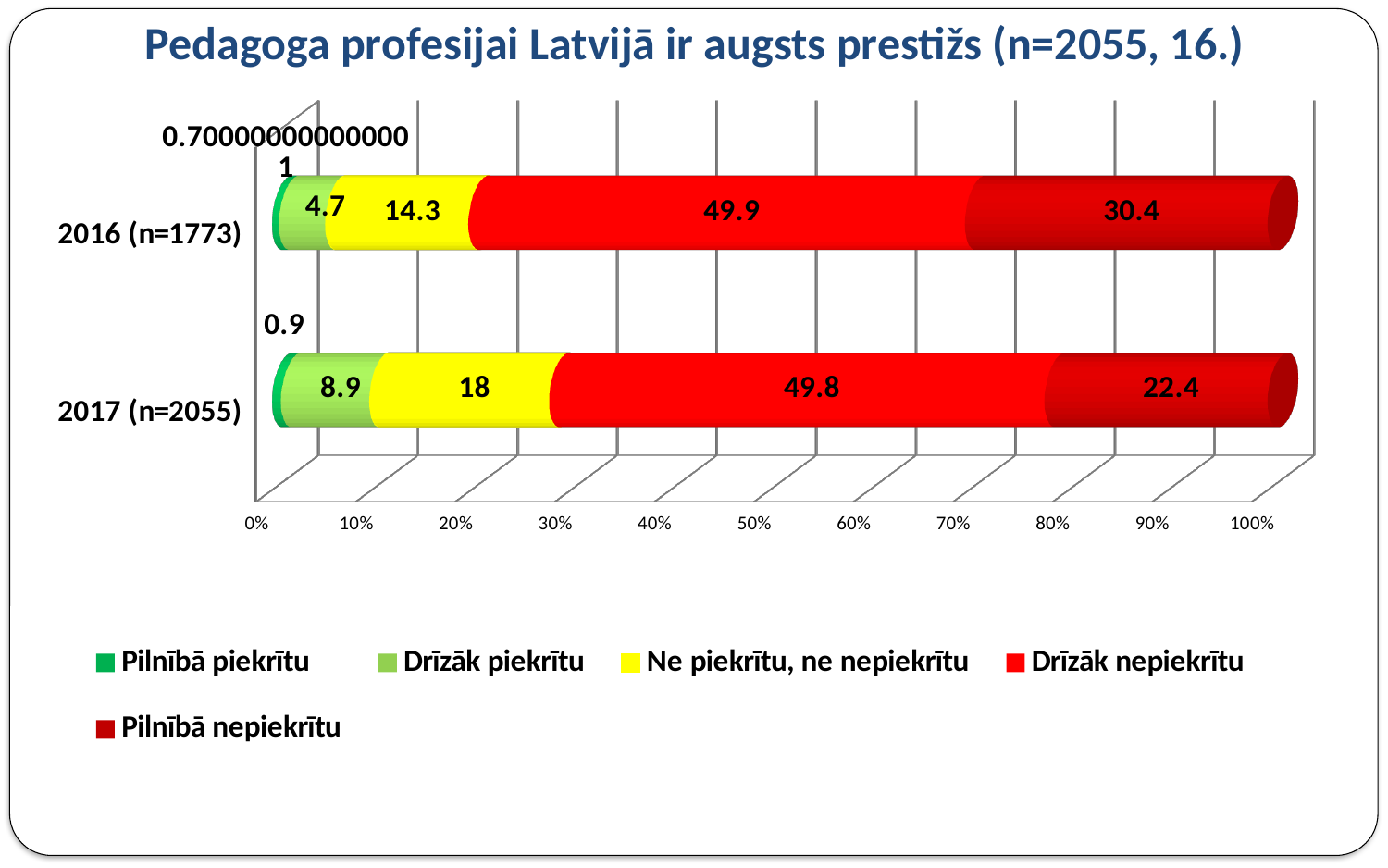
What kind of chart is shown on the slide? Stacked bar chart What is the value for 'Pilnībā nepiekrītu' in 2016 (n=1773)? 30.4 Which series has the largest value in the 2016 (n=1773) bar? Drīzāk nepiekrītu How many series does the legend list? 5 What is the value for 'Ne piekrītu, ne nepiekrītu' in 2016 (n=1773)? 14.3 What is the value for 'Drīzāk piekrītu' in 2017 (n=2055)? 8.9 What is the value for 'Pilnībā piekrītu' in 2017 (n=2055)? 0.9 How many categories (years) are plotted on the chart? 2 What is the title of the chart? Pedagoga profesijai Latvijā ir augsts prestižs (n=2055, 16.) What is the difference between the 'Pilnībā nepiekrītu' values for 2016 (n=1773) and 2017 (n=2055)? 8 Which year has the larger value for 'Ne piekrītu, ne nepiekrītu', 2016 (n=1773) or 2017 (n=2055)? 2017 (n=2055) What is the value for 'Drīzāk nepiekrītu' in 2017 (n=2055)? 49.8